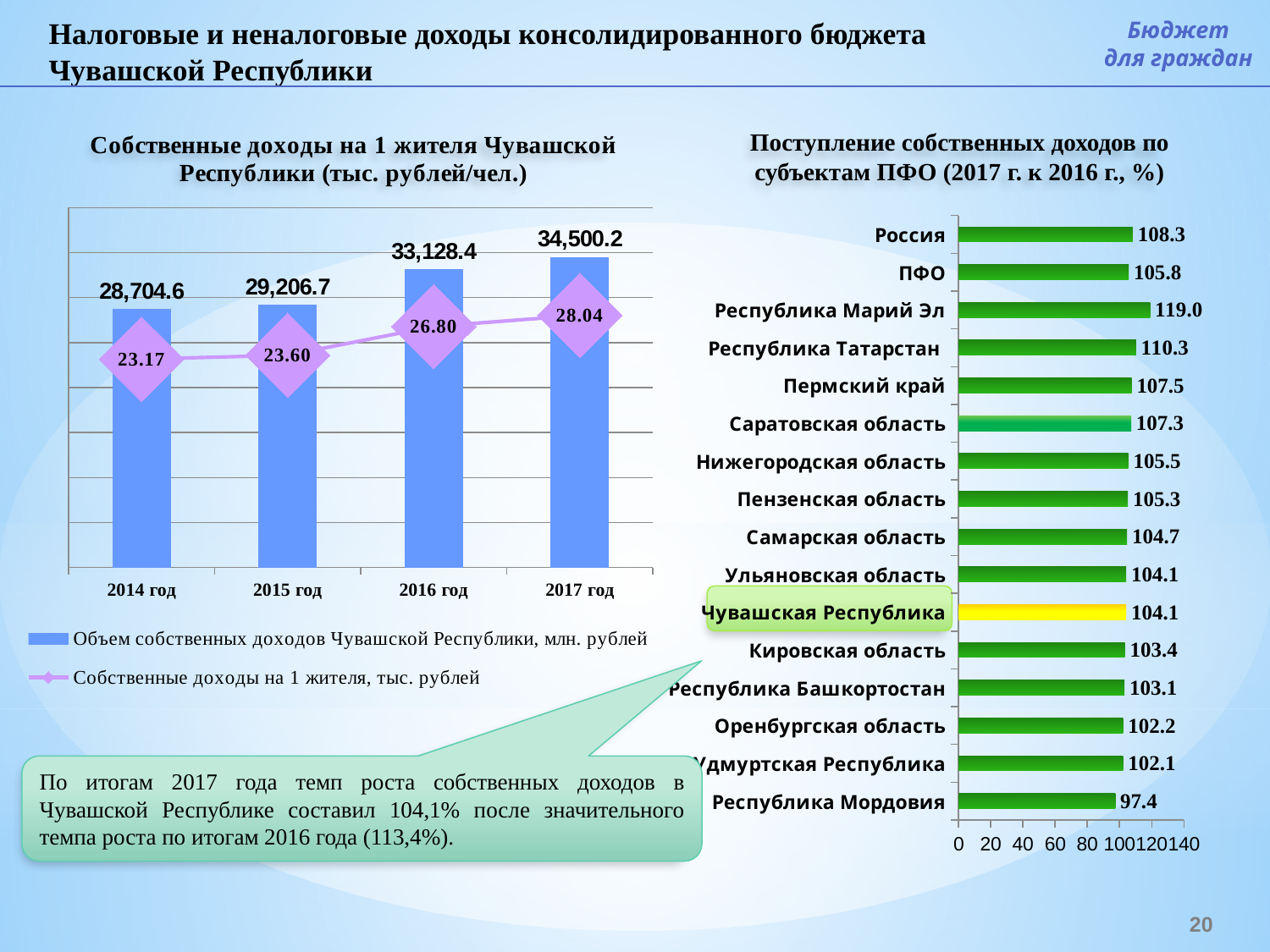
In the right chart, which region has the lowest value? Республика Мордовия In the left chart (Собственные доходы на 1 жителя Чувашской Республики), what is the value of the bar for 2017 год? 34,500.2 In the left chart, what is the value of the line marker for 2014 год? 23.17 In the left chart, by how much did the bar value increase from 2016 год to 2017 год? 1,371.8 In the right chart, what is the value for Чувашская Республика? 104.1 In the right chart (Поступление собственных доходов по субъектам ПФО), which region has the highest value? Республика Марий Эл In the left chart, how many series does the legend list? 2 In the right chart, what is the difference between the values for Республика Татарстан and Россия? 2.0 In the left chart, do the line values rise or fall from 2014 год to 2017 год? rise In the right chart, which is larger: the value for Пермский край or the value for Кировская область? Пермский край What kind of chart is the right chart? bar chart In the left chart, how many years are shown on the x axis? 4